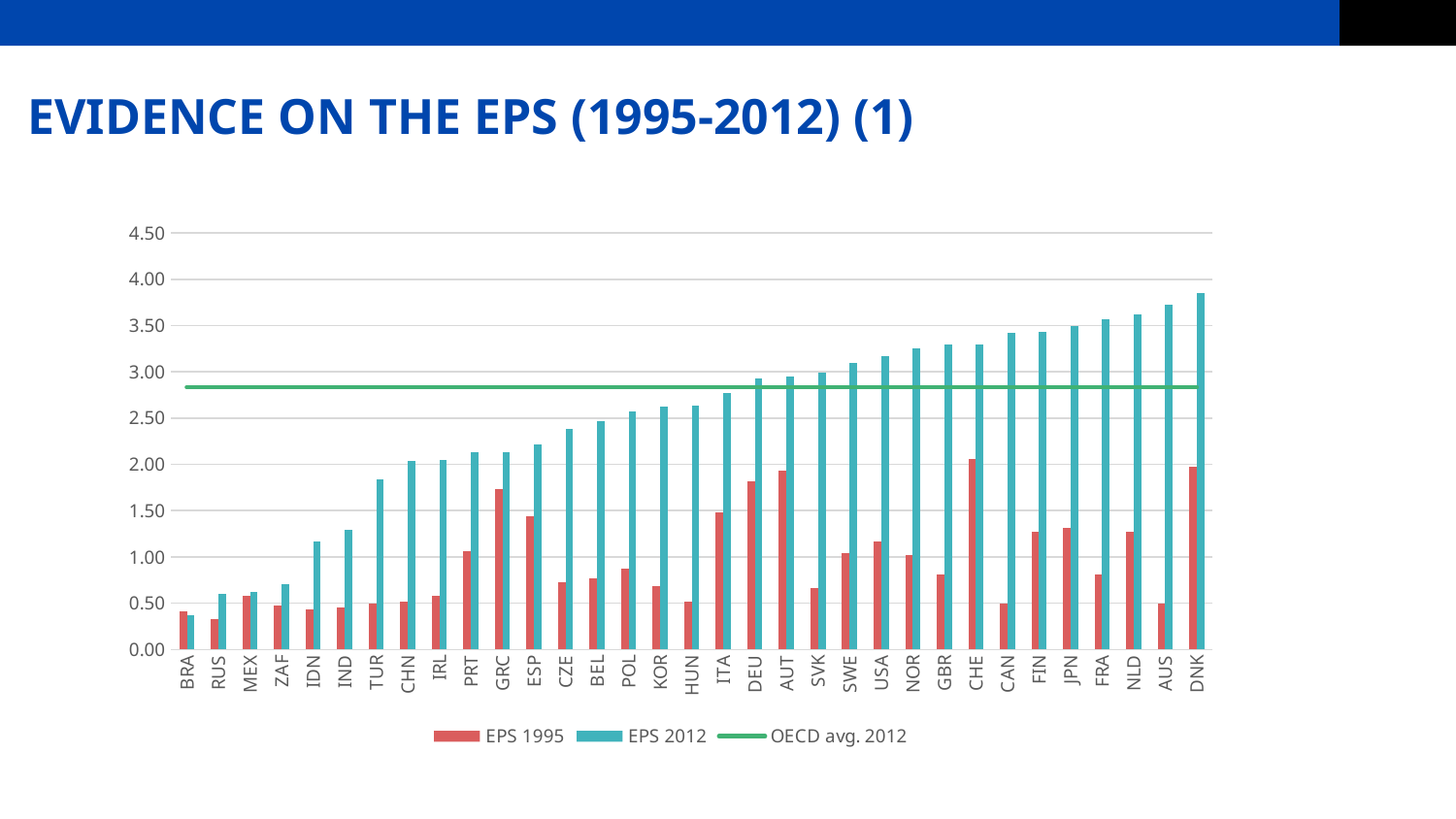
How many countries are shown on the x axis? 33 Is the EPS 2012 value for ITA greater or less than 3.00? less What is the title of the slide? EVIDENCE ON THE EPS (1995-2012) (1) How many series does the legend list? 3 Is the EPS 2012 value for USA greater or less than 3.00? greater Which country has the highest EPS 2012 value? DNK Which country has the lowest EPS 2012 value? BRA Is the OECD avg. 2012 line greater or less than 3.00? less Do the EPS 2012 values rise or fall moving from left to right along the x axis? rise Which is larger, the EPS 1995 value for GRC or for PRT? GRC What kind of chart is shown on the slide? Bar and line chart